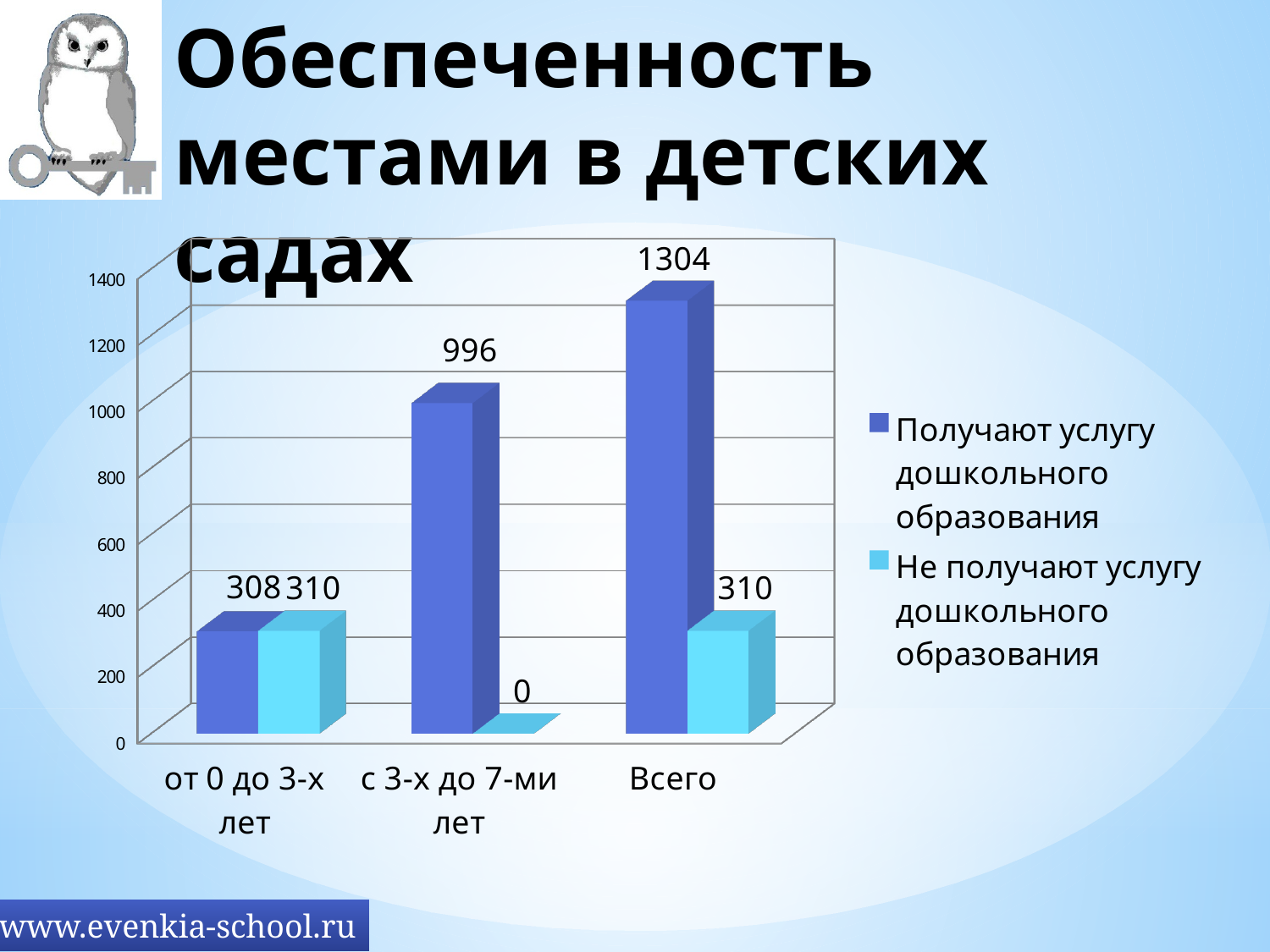
What type of chart is shown on the slide? bar chart What is the title of the chart on the slide? Обеспеченность местами в детских садах How many categories are shown on the x axis? 3 What is the value for 'Не получают услугу дошкольного образования' in the category 'с 3-х до 7-ми лет'? 0 What is the value for 'Получают услугу дошкольного образования' in the category 'Всего'? 1304 Which category has the highest value for 'Получают услугу дошкольного образования'? Всего What is the value for 'Получают услугу дошкольного образования' in the category 'с 3-х до 7-ми лет'? 996 Which is larger in the category 'Всего': 'Получают услугу дошкольного образования' or 'Не получают услугу дошкольного образования'? Получают услугу дошкольного образования Which category has the lowest value for 'Не получают услугу дошкольного образования'? с 3-х до 7-ми лет How many series does the legend list? 2 What is the difference between the 'Получают услугу дошкольного образования' values for 'Всего' and 'с 3-х до 7-ми лет'? 308 What is the value for 'Не получают услугу дошкольного образования' in the category 'от 0 до 3-х лет'? 310